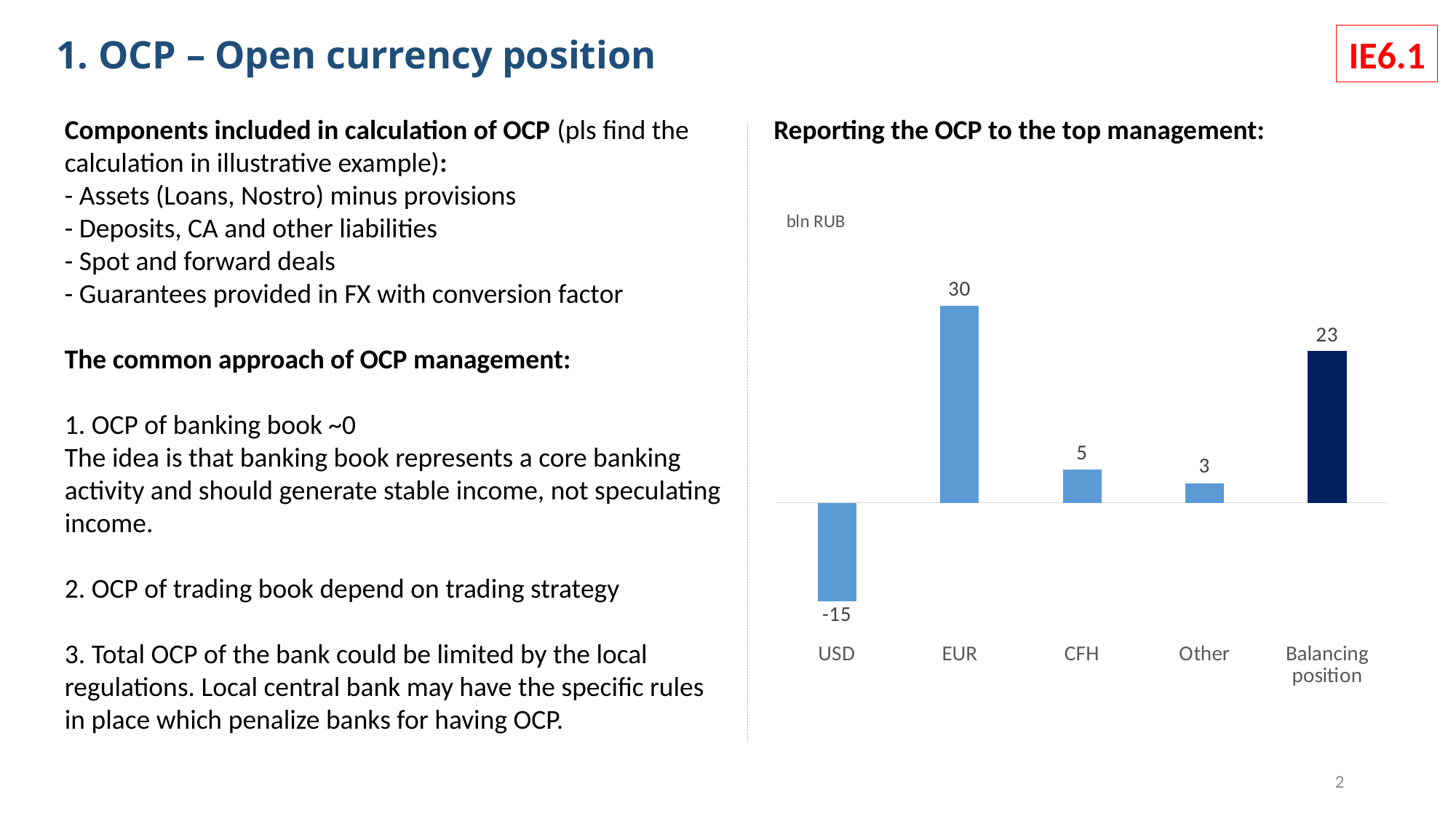
What kind of chart is shown on the slide? Bar chart Which bar is shown in a darker blue than the others? Balancing position Which category has the highest value? EUR How many categories are shown on the x axis? 5 What is the difference between the values for EUR and Balancing position? 7 What is the value for USD? -15 What is the value for EUR? 30 Which category has the lowest value? USD What is the value for CFH? 5 What is the value for Balancing position? 23 What unit is indicated above the chart? bln RUB Which is larger, the value for CFH or the value for Other? CFH